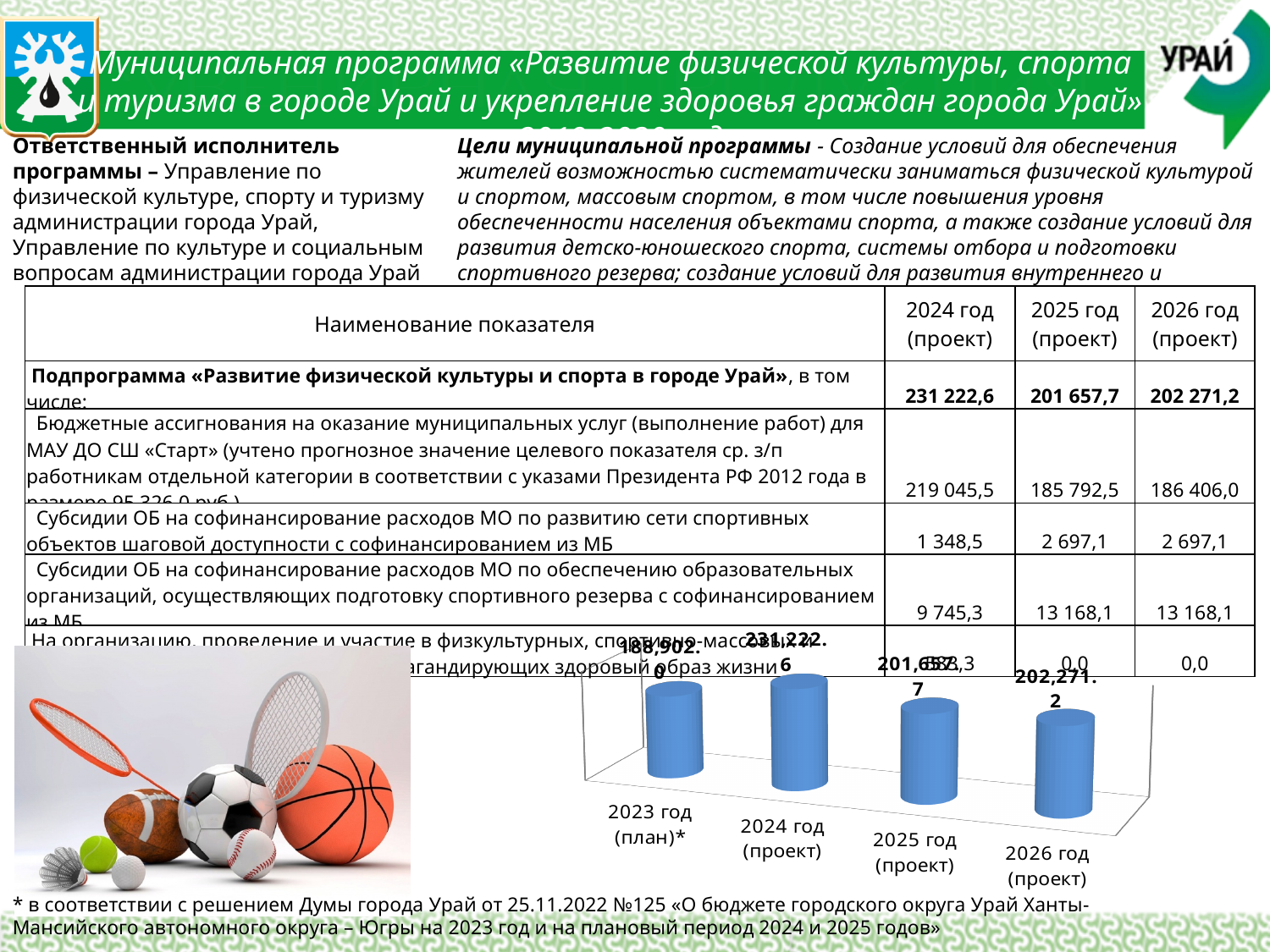
Which year has the highest value in the chart? 2024 год (проект) How many categories (years) are plotted in the chart? 4 What is the difference between the chart values for 2024 год (проект) and 2025 год (проект)? 29,564.9 What colour are the bars in the chart? blue Which is larger in the chart, the value for 2023 год (план)* or for 2024 год (проект)? 2024 год (проект) What is the value shown for 2023 год (план)* in the chart? 188,902.0 What is the value shown for 2026 год (проект) in the chart? 202,271.2 What is the value shown for 2025 год (проект) in the chart? 201,657.7 What kind of chart is shown at the bottom of the slide? bar chart Does the value in the chart rise or fall from 2024 год (проект) to 2025 год (проект)? fall What is the value shown for 2024 год (проект) in the chart? 231,222.6 Which year has the lowest value in the chart? 2023 год (план)*